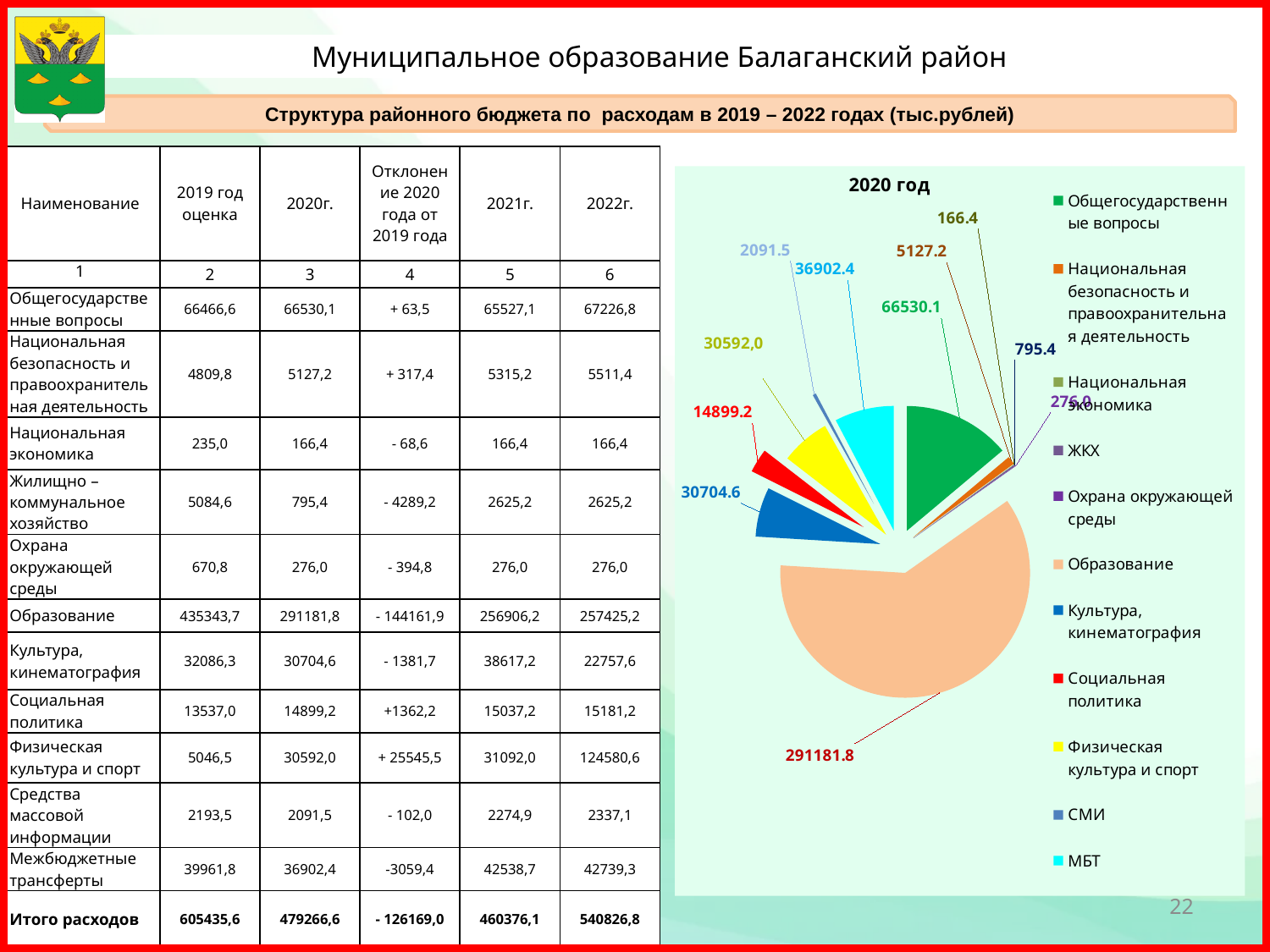
In the pie chart, what is the value for МБТ? 36902.4 What kind of chart is shown on the right side of the slide? pie chart In the pie chart, what is the difference between Общегосударственные вопросы and МБТ? 29627.7 Which category has the largest slice in the pie chart? Образование In the pie chart, what is the difference between Социальная политика and Национальная безопасность и правоохранительная деятельность? 9772.0 Which category has the smallest value in the pie chart? Национальная экономика What is the title of the pie chart? 2020 год In the pie chart, which is larger: Культура, кинематография or Физическая культура и спорт? Культура, кинематография How many entries does the legend of the pie chart list? 11 In the pie chart, what is the value for Общегосударственные вопросы? 66530.1 In the pie chart, what is the value for Образование? 291181.8 In the pie chart, what is the value for Социальная политика? 14899.2